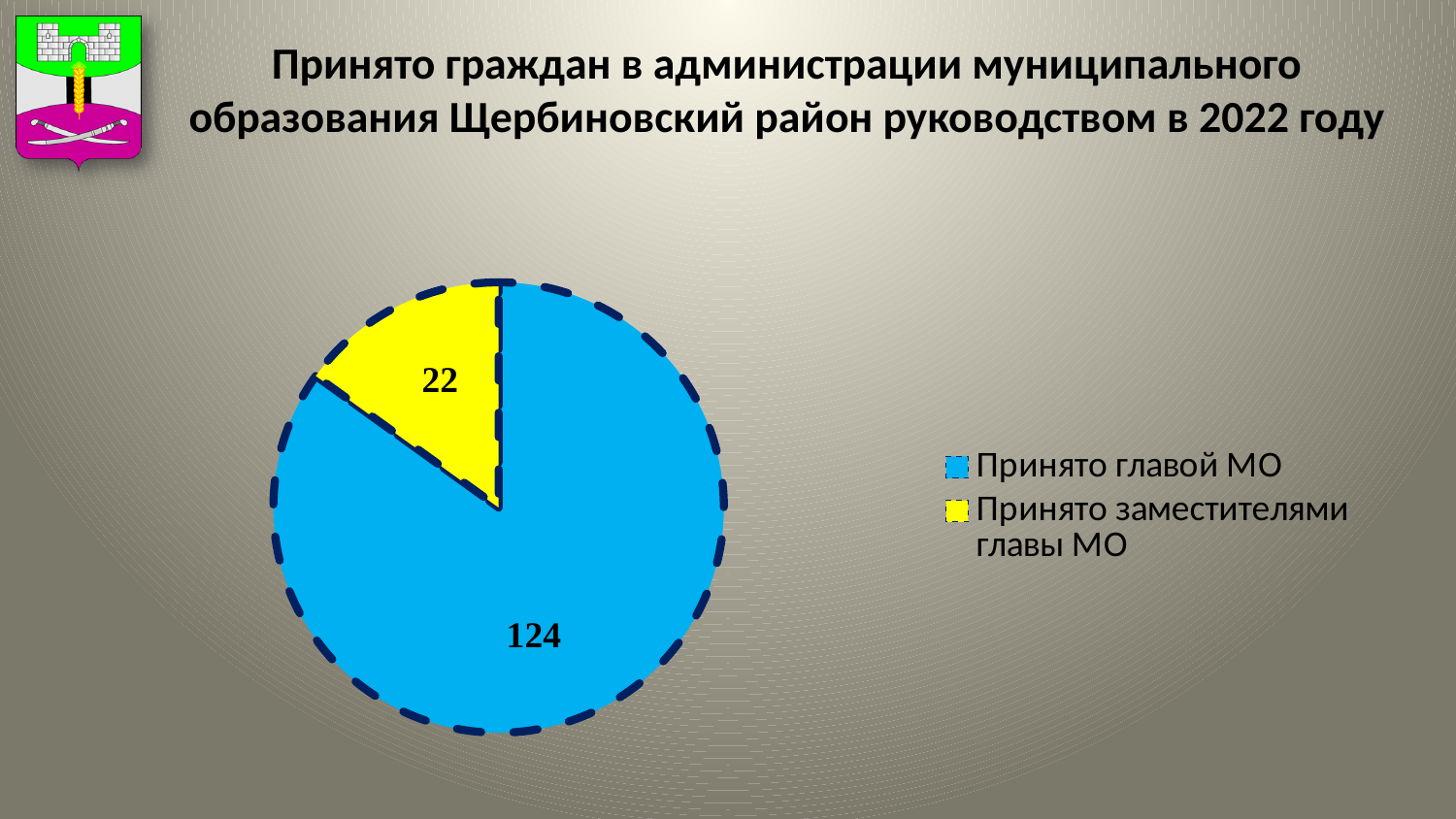
Which is larger: the number received by the head of the municipality or the number received by the deputy heads? Принято главой МО What is the total number of citizens received according to the pie chart? 146 What is the difference between the number received by the head of the municipality and the number received by the deputy heads? 102 Which category has the largest slice of the pie? Принято главой МО How many slices does the pie chart have? 2 How many citizens were received by the deputy heads of the municipality (Принято заместителями главы МО)? 22 What colour is the slice for 'Принято заместителями главы МО'? Yellow How many citizens were received by the head of the municipality (Принято главой МО)? 124 Which category has the smallest slice of the pie? Принято заместителями главы МО What colour is the slice for 'Принято главой МО'? Blue How many entries does the legend list? 2 What type of chart is shown on the slide? Pie chart